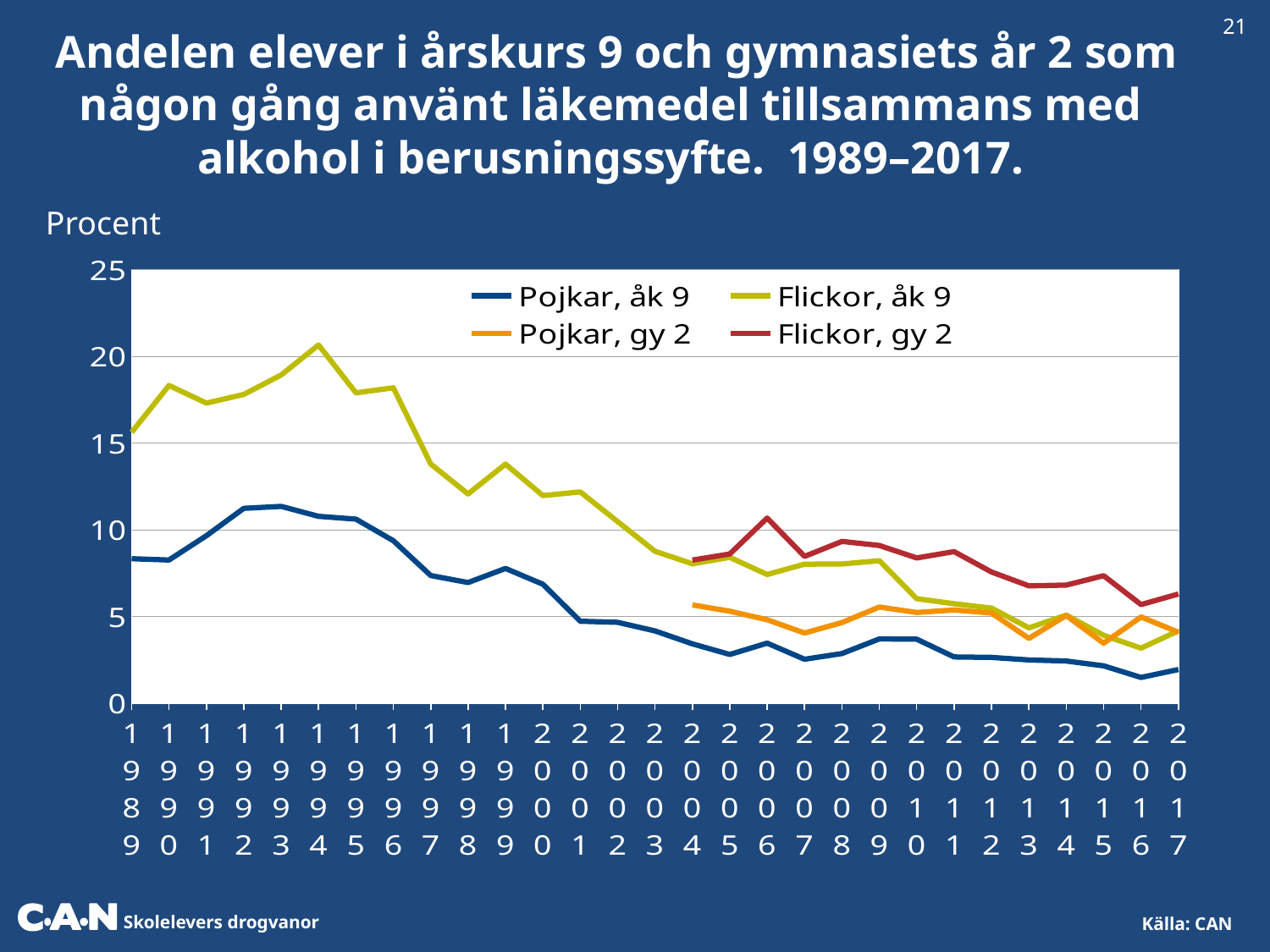
Which series has the lowest value in 2016? Pojkar, åk 9 Is the value for Flickor, åk 9 in 1990 greater or less than 15? greater Is the value for Pojkar, åk 9 in 1993 greater or less than 10? greater How many series does the legend list? 4 Which series has the highest value in 1994? Flickor, åk 9 In 2017, which is higher: Flickor, gy 2 or Pojkar, gy 2? Flickor, gy 2 Is the value for Pojkar, åk 9 in 2016 greater or less than 5? less What kind of chart is shown on the slide? line chart What label is shown on the vertical axis of the chart? Procent Does the Pojkar, åk 9 series generally rise or fall from 1989 to 2017? fall How many years are shown along the x axis? 29